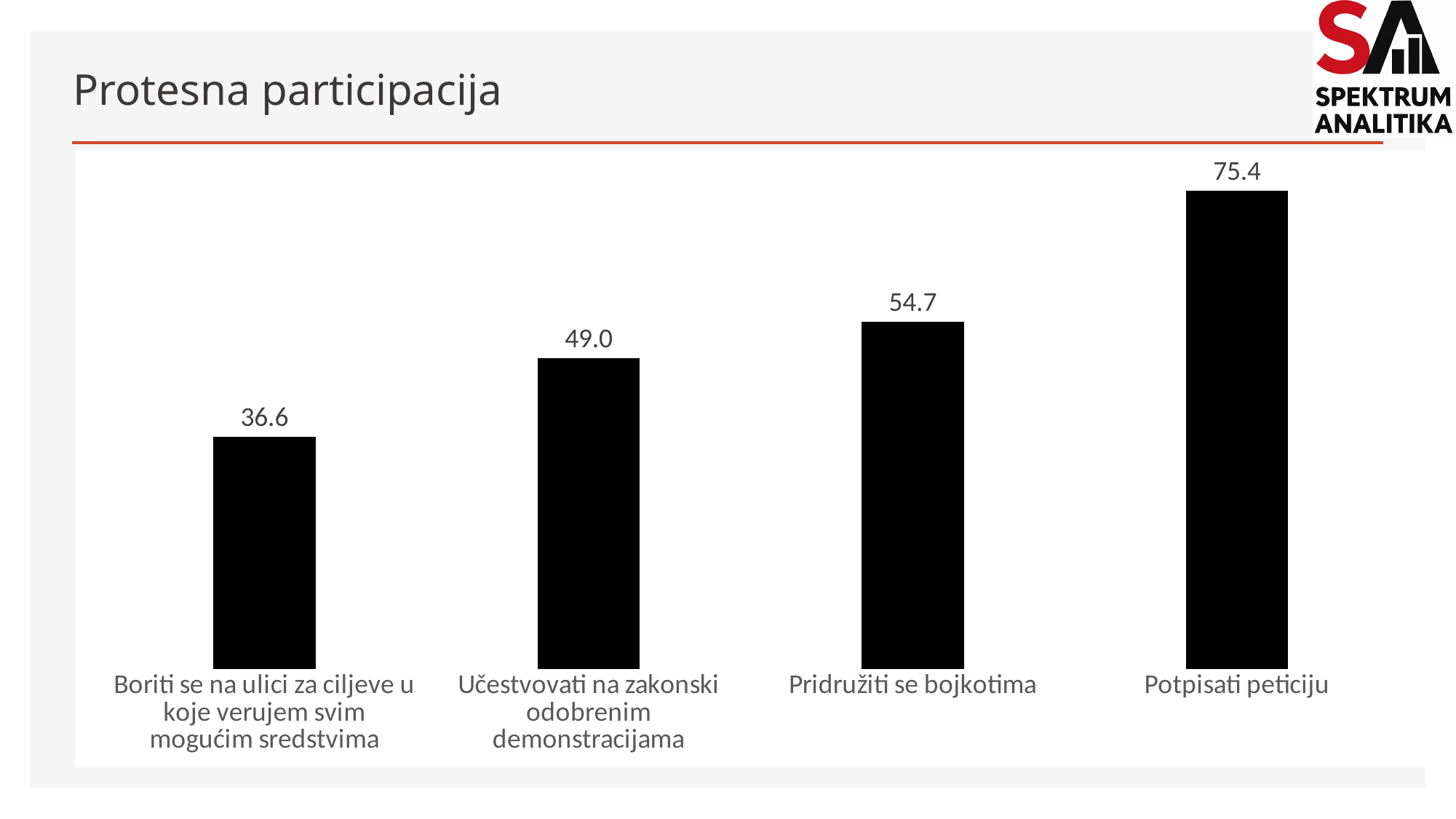
What is the value for "Pridružiti se bojkotima"? 54.7 Do the values rise or fall from left to right along the x axis? Rise Which category has the highest value? Potpisati peticiju Which category has the lowest value? Boriti se na ulici za ciljeve u koje verujem svim mogućim sredstvima What kind of chart is shown on the slide? Bar chart What is the value for "Potpisati peticiju"? 75.4 What is the value for "Boriti se na ulici za ciljeve u koje verujem svim mogućim sredstvima"? 36.6 How many categories are shown in the chart? 4 What is the difference between the values for "Potpisati peticiju" and "Pridružiti se bojkotima"? 20.7 What is the difference between the values for "Učestvovati na zakonski odobrenim demonstracijama" and "Boriti se na ulici za ciljeve u koje verujem svim mogućim sredstvima"? 12.4 What is the value for "Učestvovati na zakonski odobrenim demonstracijama"? 49.0 Which is larger, the value for "Pridružiti se bojkotima" or the value for "Učestvovati na zakonski odobrenim demonstracijama"? Pridružiti se bojkotima